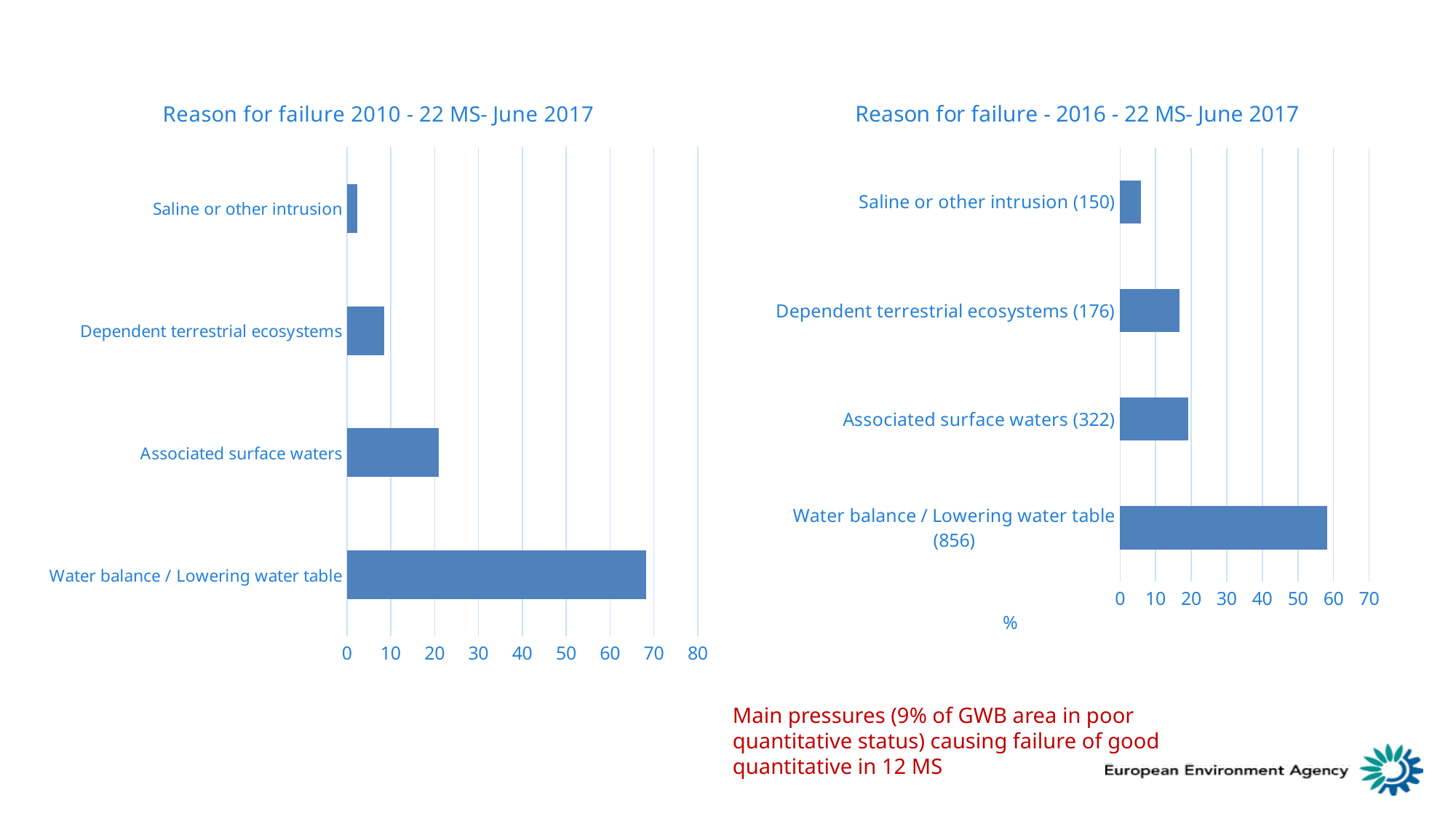
In the left chart (Reason for failure 2010), which category has the lowest value? Saline or other intrusion What type of chart is the left chart titled 'Reason for failure 2010 - 22 MS- June 2017'? bar chart In the right chart (Reason for failure 2016), which category has the lowest value? Saline or other intrusion (150) In the left chart (Reason for failure 2010), which is larger: Associated surface waters or Dependent terrestrial ecosystems? Associated surface waters In the left chart (Reason for failure 2010), which category has the highest value? Water balance / Lowering water table In the left chart (Reason for failure 2010), is the value for Water balance / Lowering water table greater or less than 60? greater How many categories are shown in the right chart titled 'Reason for failure - 2016 - 22 MS- June 2017'? 4 In the right chart (Reason for failure 2016), is the value for Saline or other intrusion (150) greater or less than 10? less In the right chart (Reason for failure 2016), is the value for Water balance / Lowering water table (856) greater or less than 50? greater In the right chart (Reason for failure 2016), which category has the highest value? Water balance / Lowering water table (856) What unit label is shown below the x axis of the right chart (Reason for failure 2016)? %